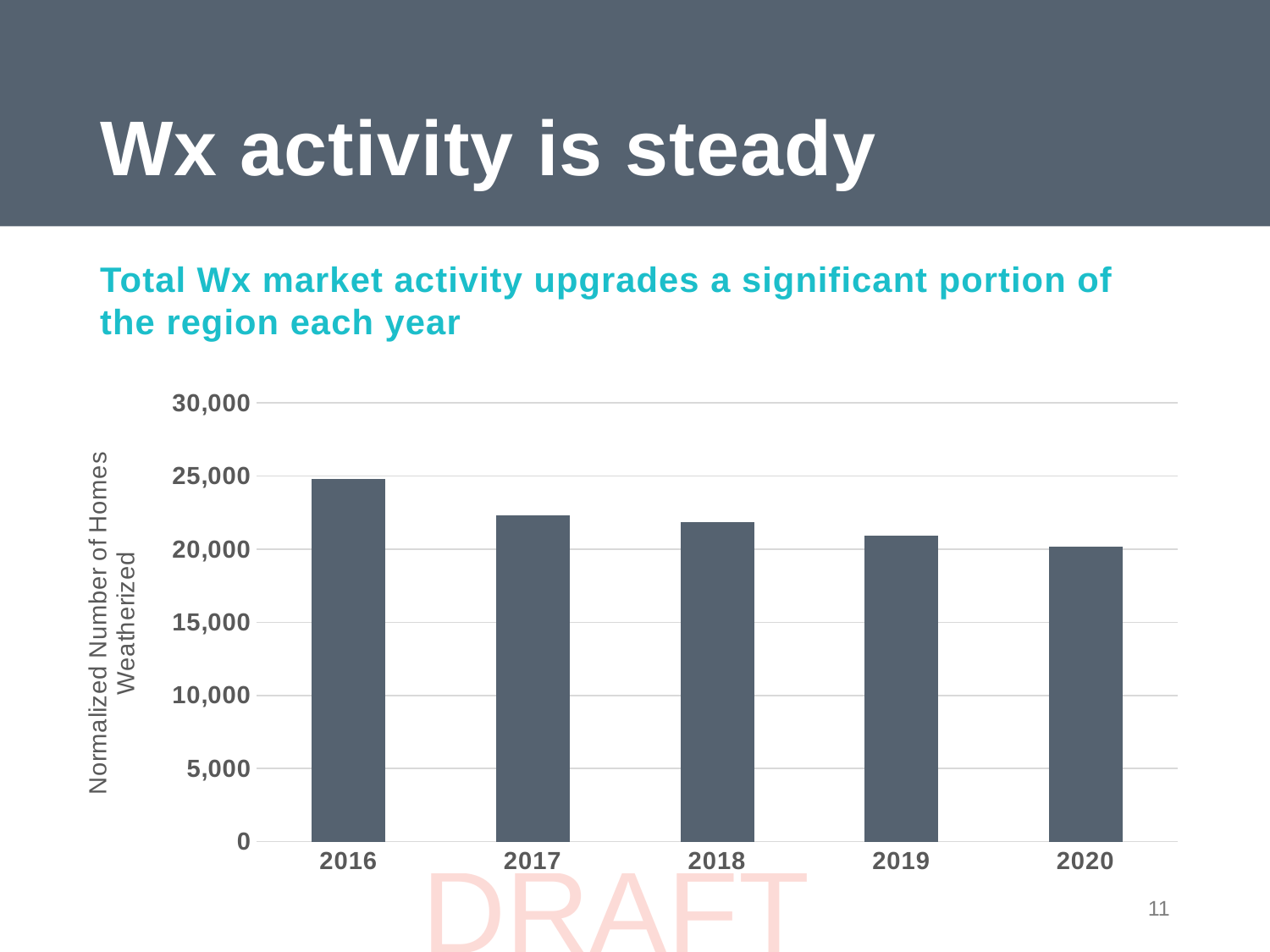
Do the values rise or fall from 2016 to 2020? fall Is the value for 2020 greater or less than 25,000? less Is the value for 2018 greater or less than 20,000? greater Is the value for 2016 greater or less than 20,000? greater Which year has the highest normalized number of homes weatherized? 2016 Which year has a larger value, 2017 or 2019? 2017 What kind of chart is shown on the slide? bar chart Which year has the lowest normalized number of homes weatherized? 2020 What is the label on the y axis of the chart? Normalized Number of Homes Weatherized Which year has a larger value, 2016 or 2020? 2016 How many years are shown on the x axis of the chart? 5